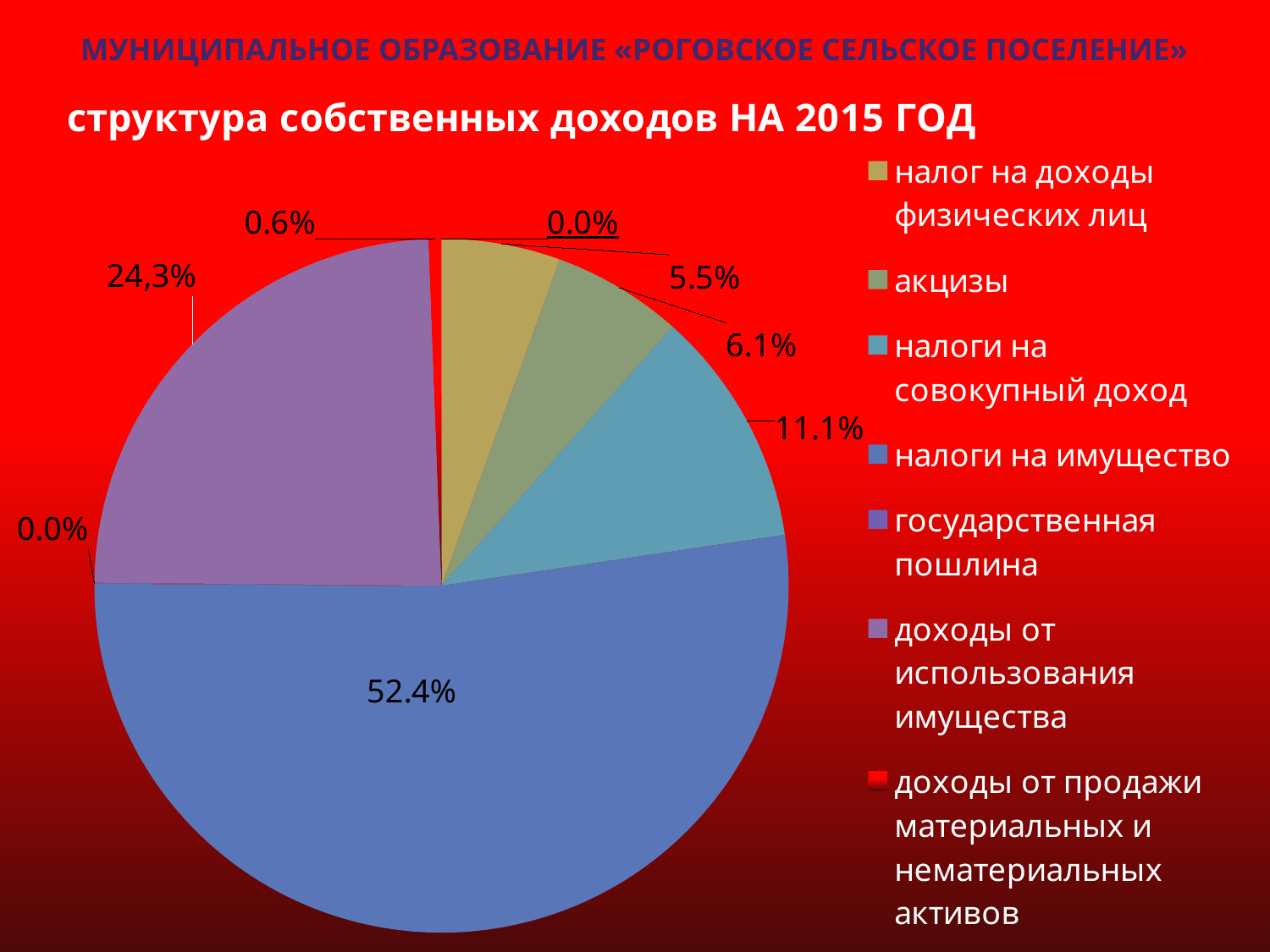
What share of the pie does «акцизы» take? 6.1% What share of the pie does «налог на доходы физических лиц» take? 5.5% What share of the pie does «доходы от продажи материальных и нематериальных активов» take? 0.6% How many entries does the legend list? 7 Which category has the largest slice of the pie? налоги на имущество Which is larger: the slice for «налоги на совокупный доход» or the slice for «акцизы»? налоги на совокупный доход What is the title of the chart? структура собственных доходов НА 2015 ГОД What kind of chart is shown on the slide? pie chart